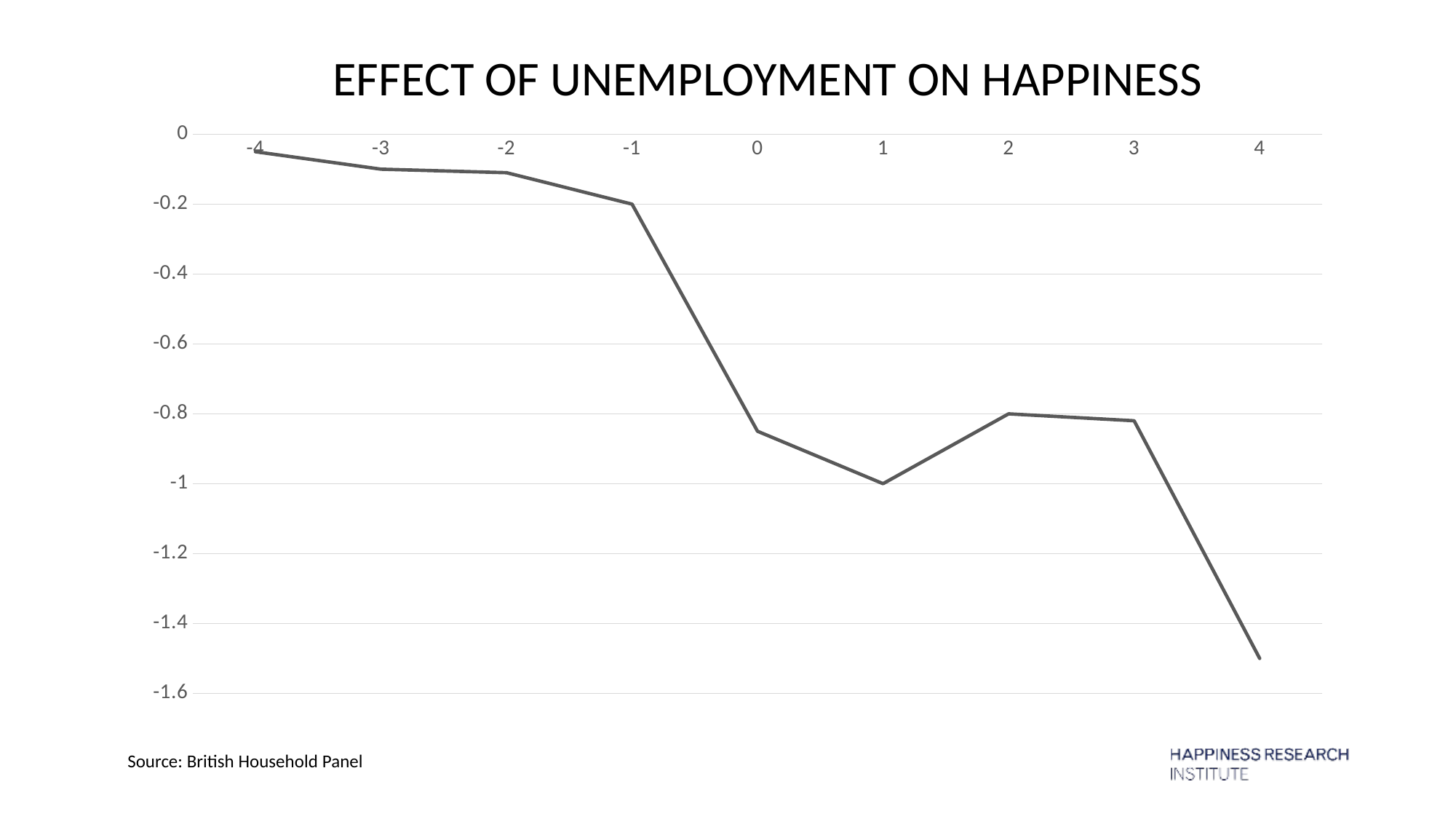
What is the value at x = 1? -1 What is the title of the chart? EFFECT OF UNEMPLOYMENT ON HAPPINESS At which x-axis value is the plotted value highest? -4 Is the value at x = -3 greater or less than -0.2? greater Overall, do the values rise or fall as x increases from -4 to 4? fall At which x-axis value is the plotted value lowest? 4 Which is larger, the value at x = 2 or the value at x = 4? x = 2 Is the value at x = 4 greater or less than -1.4? less What is the value at x = -1? -0.2 Is the value at x = 0 greater or less than -1? greater How many data points are plotted on the line? 9 What kind of chart is shown on the slide? line chart